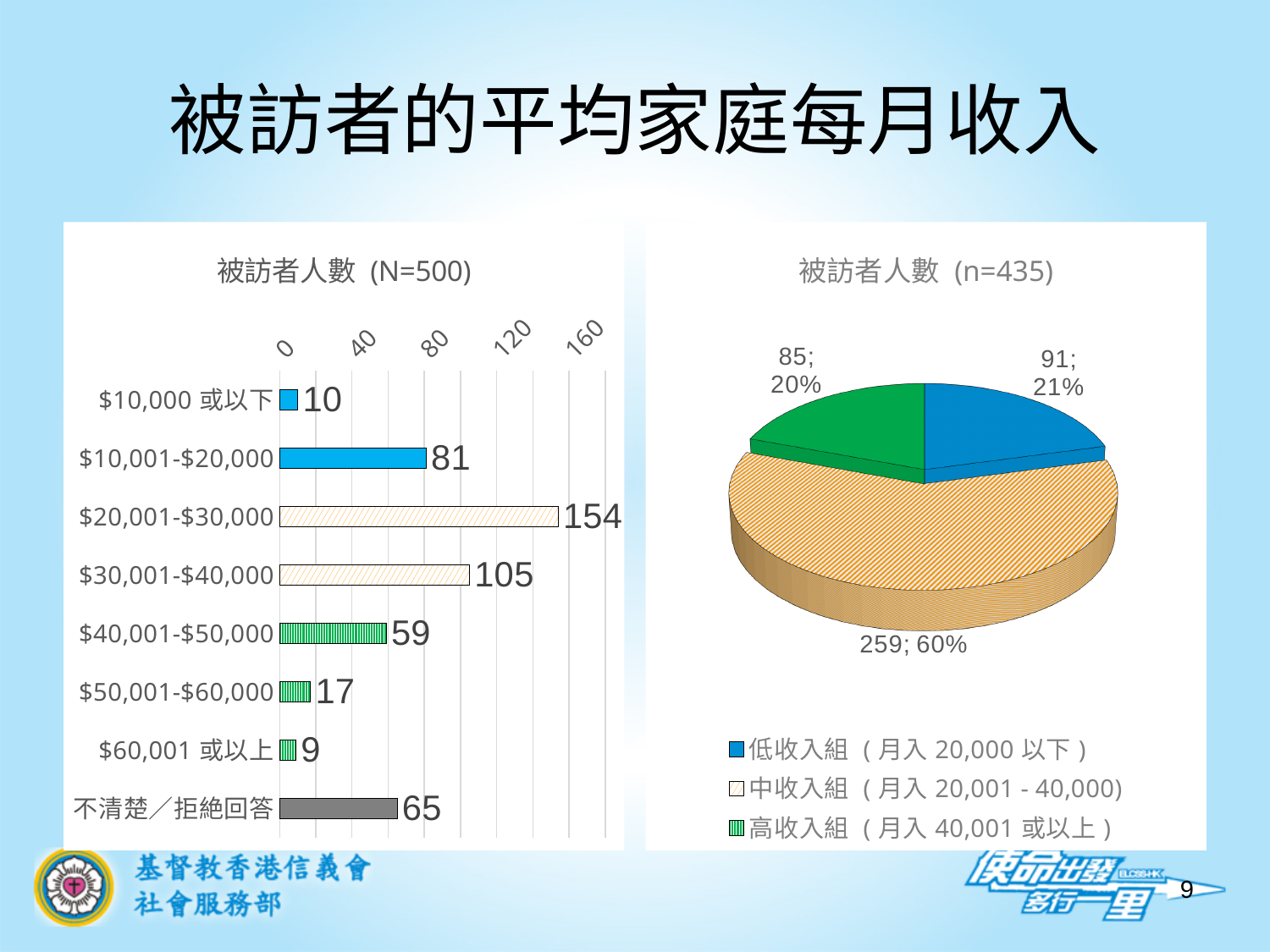
In the bar chart titled 被訪者人數 (N=500), which category has the highest value? $20,001-$30,000 How many entries does the legend of the pie chart titled 被訪者人數 (n=435) list? 3 In the bar chart titled 被訪者人數 (N=500), what is the difference between the values for $20,001-$30,000 and $30,001-$40,000? 49 What kind of chart is the chart on the left titled 被訪者人數 (N=500)? bar chart In the pie chart titled 被訪者人數 (n=435), which group has the largest slice? 中收入組 In the bar chart titled 被訪者人數 (N=500), which category has the lowest value? $60,001 或以上 In the pie chart titled 被訪者人數 (n=435), what share does 中收入組 have? 60% In the bar chart titled 被訪者人數 (N=500), what is the value for 不清楚／拒絕回答? 65 In the bar chart titled 被訪者人數 (N=500), which is larger: the value for $10,001-$20,000 or the value for $40,001-$50,000? $10,001-$20,000 How many categories does the bar chart titled 被訪者人數 (N=500) show? 8 In the bar chart titled 被訪者人數 (N=500), what is the value for $20,001-$30,000? 154 In the pie chart titled 被訪者人數 (n=435), what is the value for 高收入組? 85